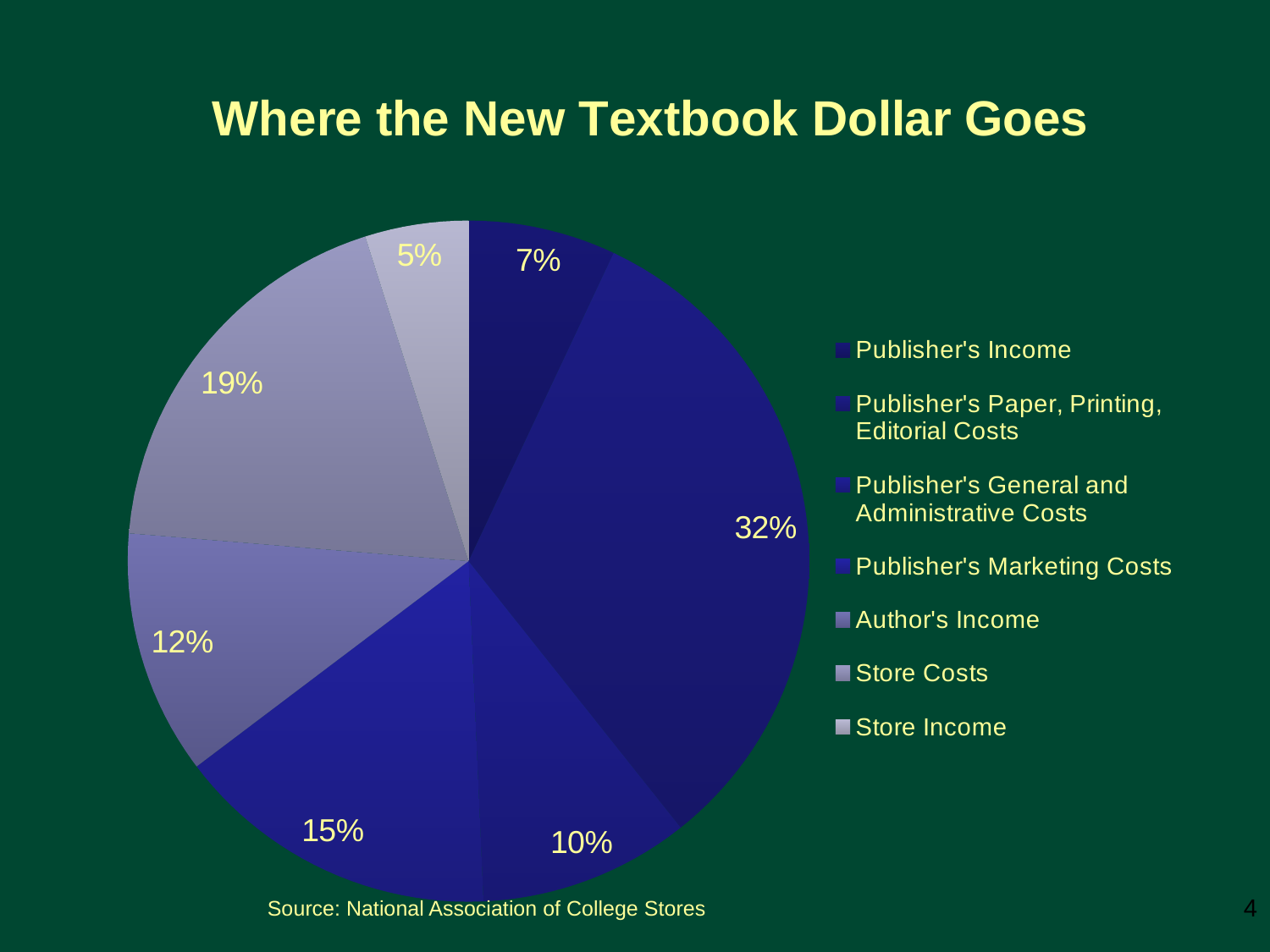
Which is larger, Publisher's Marketing Costs or Publisher's General and Administrative Costs? Publisher's Marketing Costs How many categories does the pie chart show? 7 What type of chart is shown on the slide? Pie chart What source is cited for the chart data? National Association of College Stores What percentage of the new textbook dollar goes to Author's Income? 12% Which category receives the smallest share of the new textbook dollar? Store Income How many percentage points larger is Store Costs than Publisher's Income? 12 What percentage of the new textbook dollar goes to Store Costs? 19% Which category receives the largest share of the new textbook dollar? Publisher's Paper, Printing, Editorial Costs What is the title of the chart? Where the New Textbook Dollar Goes What percentage of the new textbook dollar goes to Publisher's Paper, Printing, Editorial Costs? 32% What share of the new textbook dollar is Store Income? 5%